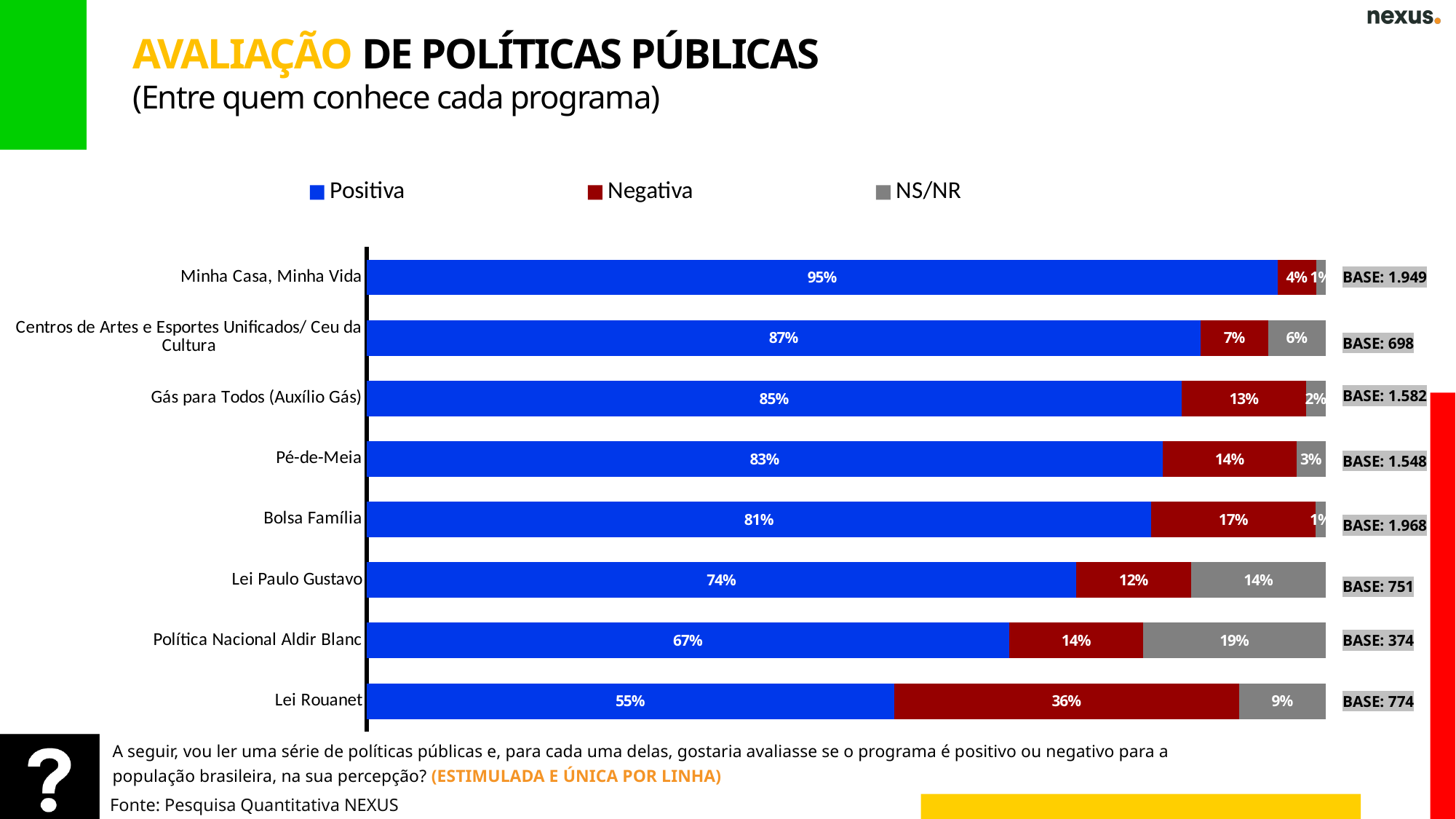
What is the NS/NR value for Política Nacional Aldir Blanc? 19% What is the Negativa value for Bolsa Família? 17% Which program has the highest Negativa value? Lei Rouanet What is the difference between the Positiva values for Minha Casa, Minha Vida and Lei Rouanet? 40% What kind of chart is shown on the slide? Stacked bar chart Which program has the lowest Positiva value? Lei Rouanet Which program has the highest Positiva value? Minha Casa, Minha Vida What is the Positiva value for Lei Rouanet? 55% What is the total of the stacked bar for Lei Paulo Gustavo? 100% Which is larger: the Negativa value for Gás para Todos (Auxílio Gás) or the Negativa value for Lei Paulo Gustavo? Gás para Todos (Auxílio Gás) How many public policies (categories) are shown in the chart? 8 How many series does the legend list? 3